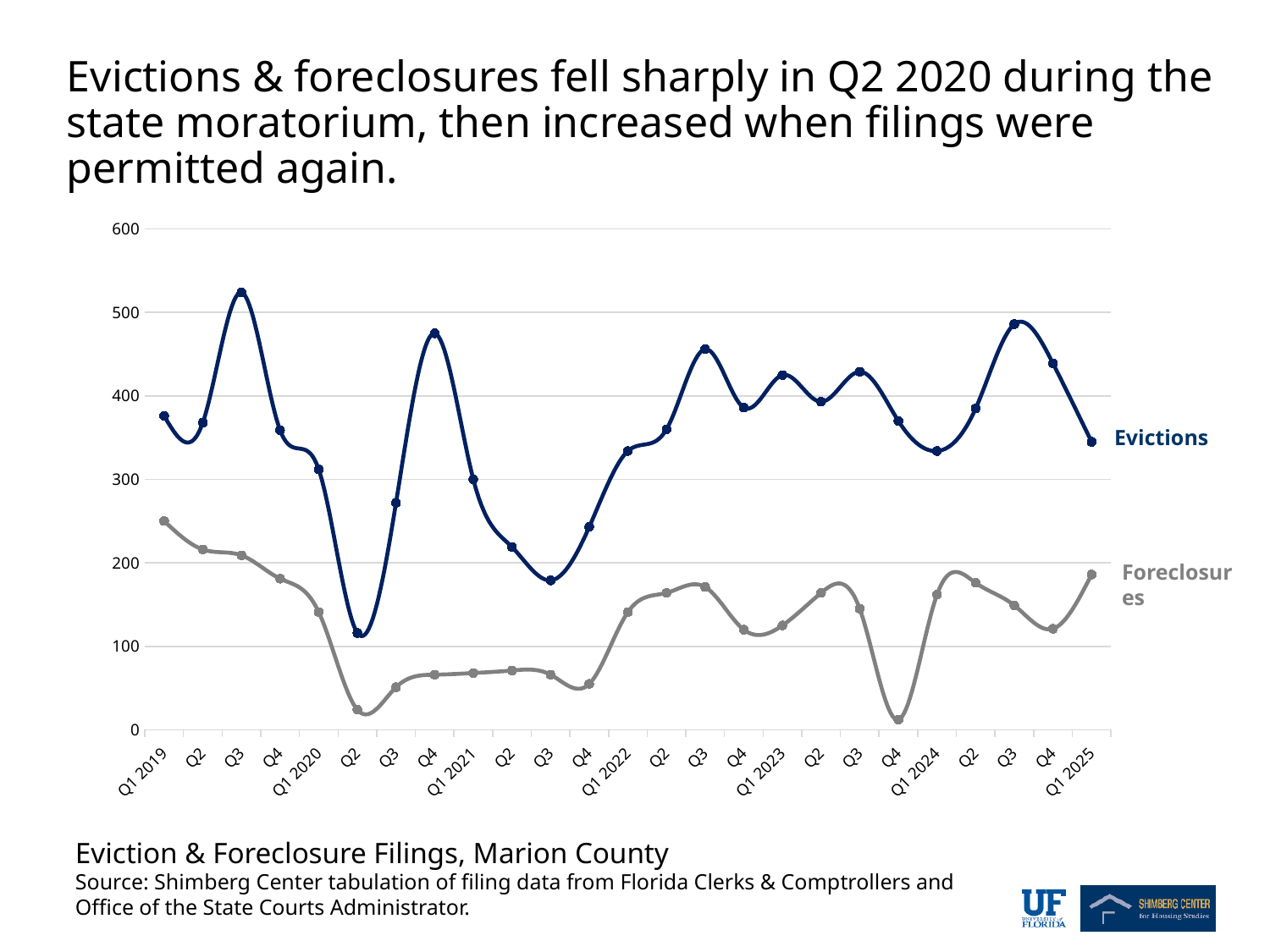
How many series are plotted on the chart? 2 In which quarter do Evictions reach their lowest value? Q2 2020 Is the value for Evictions in Q2 2020 greater or less than 200? less What is the title of the chart given below the plot? Eviction & Foreclosure Filings, Marion County In which quarter do Evictions reach their highest value? Q3 2019 Do Evictions rise or fall from Q1 2020 to Q2 2020? fall What kind of chart is shown on the slide? line chart Which series has the larger value in Q1 2019, Evictions or Foreclosures? Evictions How many quarterly data points does each line have, from Q1 2019 to Q1 2025? 25 In which quarter do Foreclosures reach their lowest value? Q4 2023 Is the value for Evictions in Q3 2019 greater or less than 500? greater Is the value for Foreclosures in Q2 2020 greater or less than 50? less